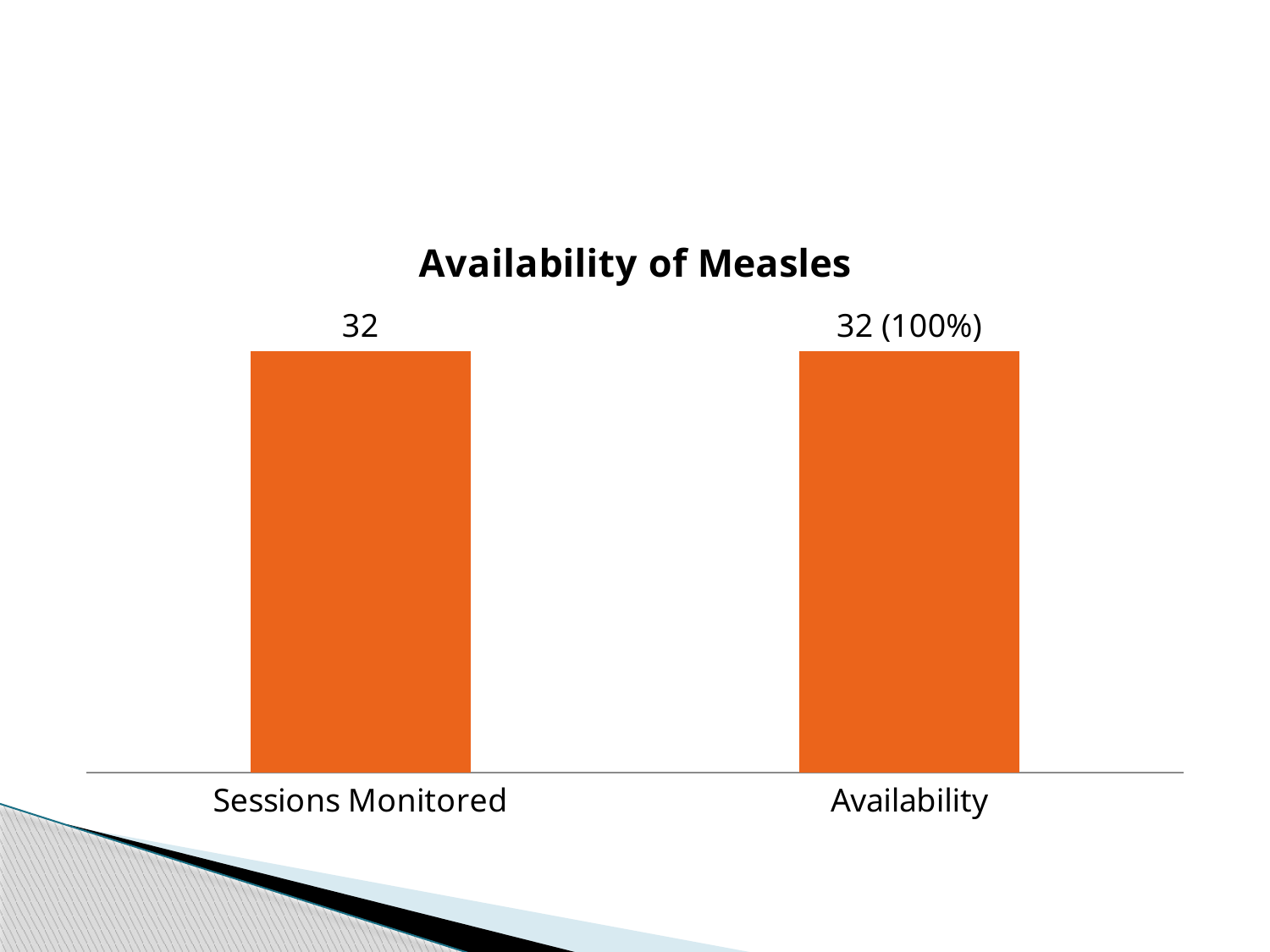
Are the values for Sessions Monitored and Availability equal? Yes What is the label of the first category on the x axis? Sessions Monitored What is the title of the chart? Availability of Measles How many categories are shown on the x axis? 2 What percentage is shown for Availability? 100% What is the difference between the Sessions Monitored value and the Availability value? 0 What colour are the bars in the chart? Orange What is the data label shown on the Availability bar? 32 (100%) What kind of chart is this? bar chart What is the value for Sessions Monitored? 32